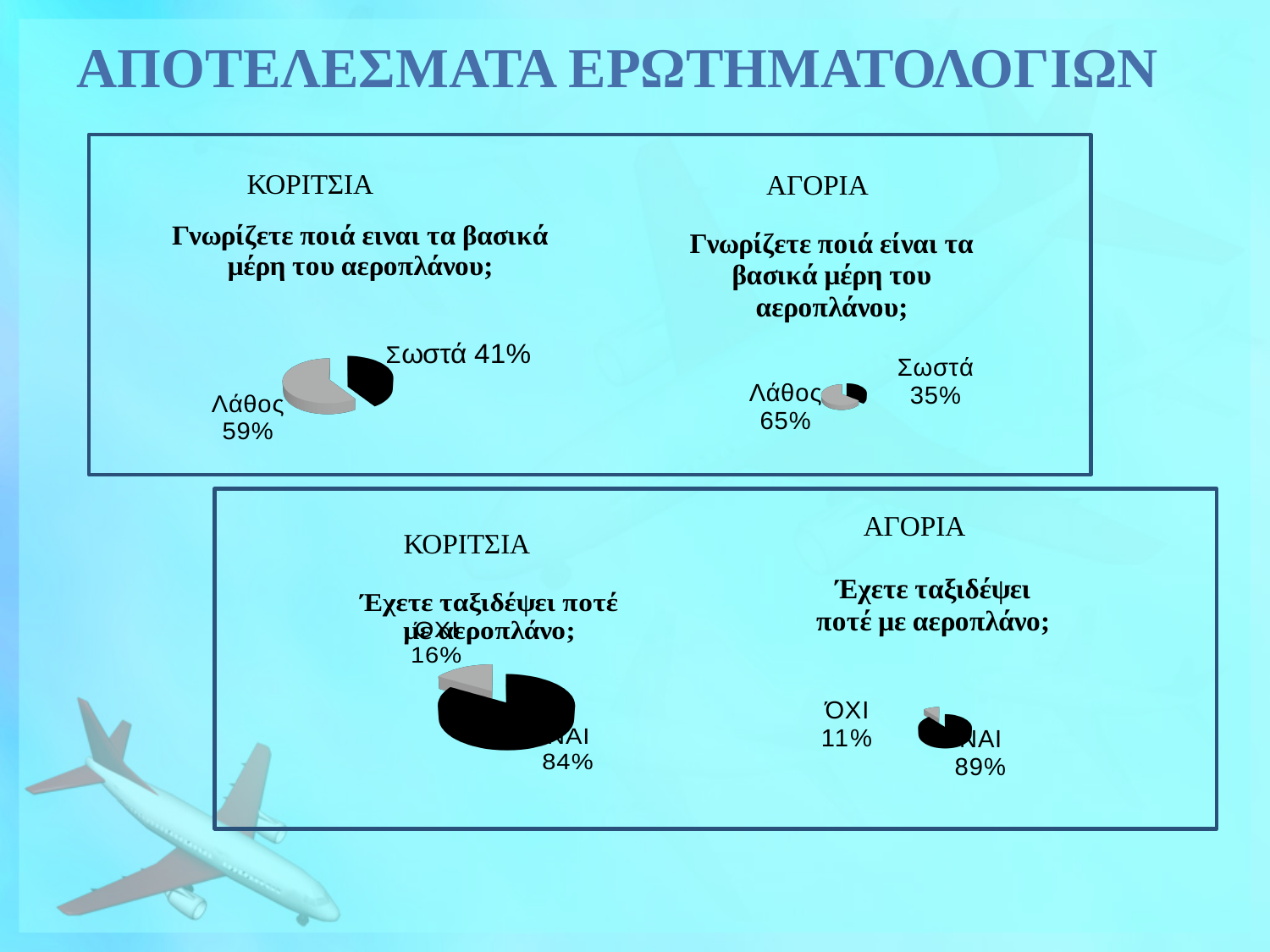
In the top-left pie chart (ΚΟΡΙΤΣΙΑ, basic parts of the airplane), what percentage is labelled Σωστά? 41% In the bottom-right pie chart (ΑΓΟΡΙΑ, have you ever travelled by airplane), what percentage answered ΌΧΙ? 11% In the top-left pie chart (ΚΟΡΙΤΣΙΑ, basic parts of the airplane), what is the difference between the Λάθος and Σωστά percentages? 18% What type of chart is used for the bottom-right chart (ΑΓΟΡΙΑ, have you ever travelled by airplane)? Pie chart In the bottom-left pie chart (ΚΟΡΙΤΣΙΑ, have you ever travelled by airplane), what percentage answered ΝΑΙ? 84% In the bottom-left pie chart (ΚΟΡΙΤΣΙΑ, have you ever travelled by airplane), which slice is the smallest? ΌΧΙ In the top-right pie chart (ΑΓΟΡΙΑ, basic parts of the airplane), which slice is the largest? Λάθος How many pie charts are shown on the slide? 4 Comparing the top-left (ΚΟΡΙΤΣΙΑ) and top-right (ΑΓΟΡΙΑ) pie charts, which group has the higher Σωστά percentage? ΚΟΡΙΤΣΙΑ In the top-right pie chart (ΑΓΟΡΙΑ, basic parts of the airplane), what percentage is labelled Λάθος? 65% In the top-right pie chart (ΑΓΟΡΙΑ, basic parts of the airplane), what percentage is labelled Σωστά? 35% In the top-left pie chart (ΚΟΡΙΤΣΙΑ, basic parts of the airplane), what percentage is labelled Λάθος? 59%